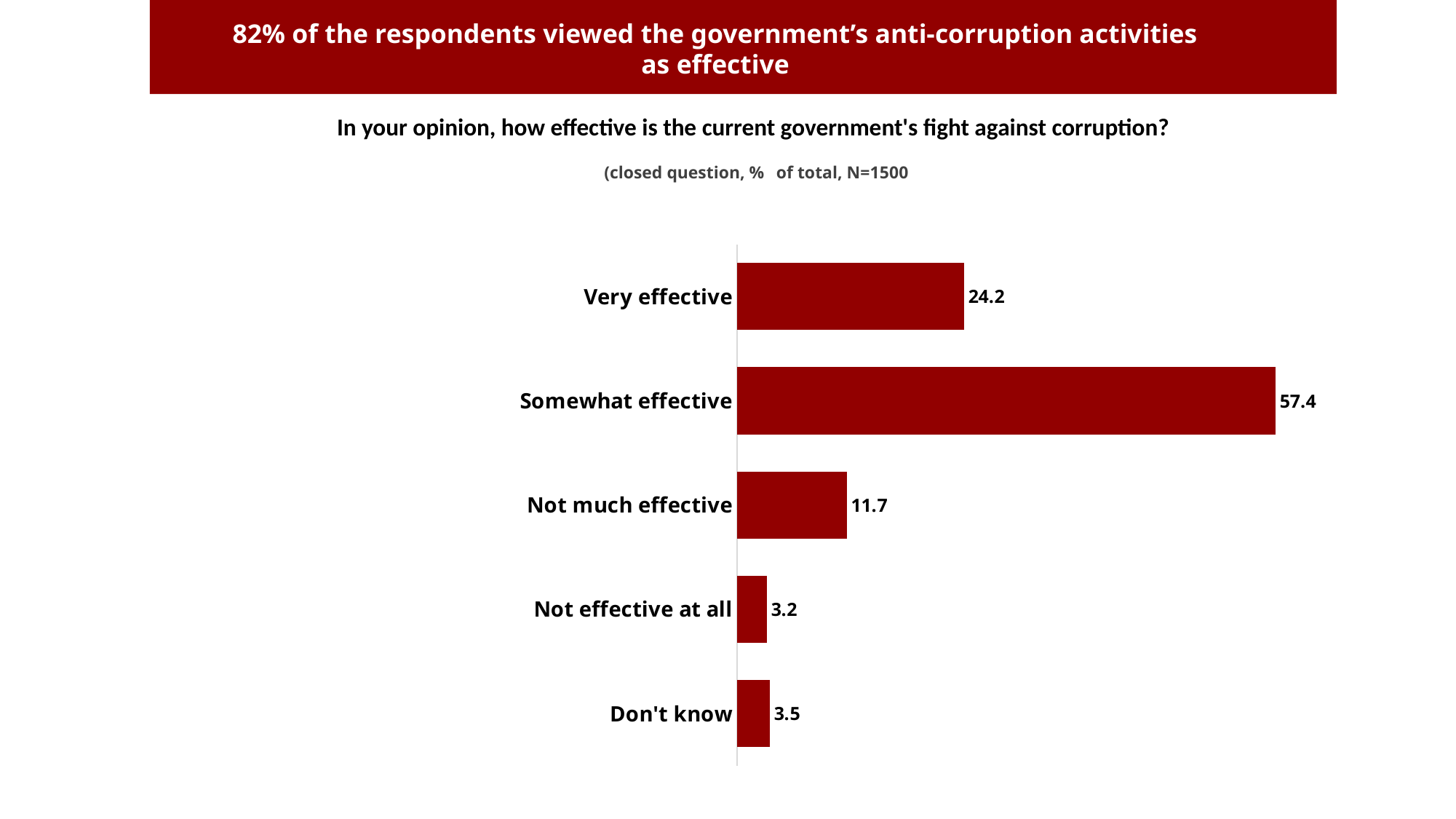
What is the value for "Don't know"? 3.5 What is the value for "Somewhat effective"? 57.4 What sample size (N) is stated on the slide? N=1500 Which is larger, the value for "Not much effective" or the value for "Don't know"? Not much effective Which category has the lowest value? Not effective at all What is the difference between the values for "Very effective" and "Not much effective"? 12.5 What is the value for "Very effective"? 24.2 What is the value for "Not much effective"? 11.7 What kind of chart is shown on the slide? Bar chart Which category has the highest value? Somewhat effective What is the difference between the values for "Somewhat effective" and "Very effective"? 33.2 How many categories are shown in the chart? 5